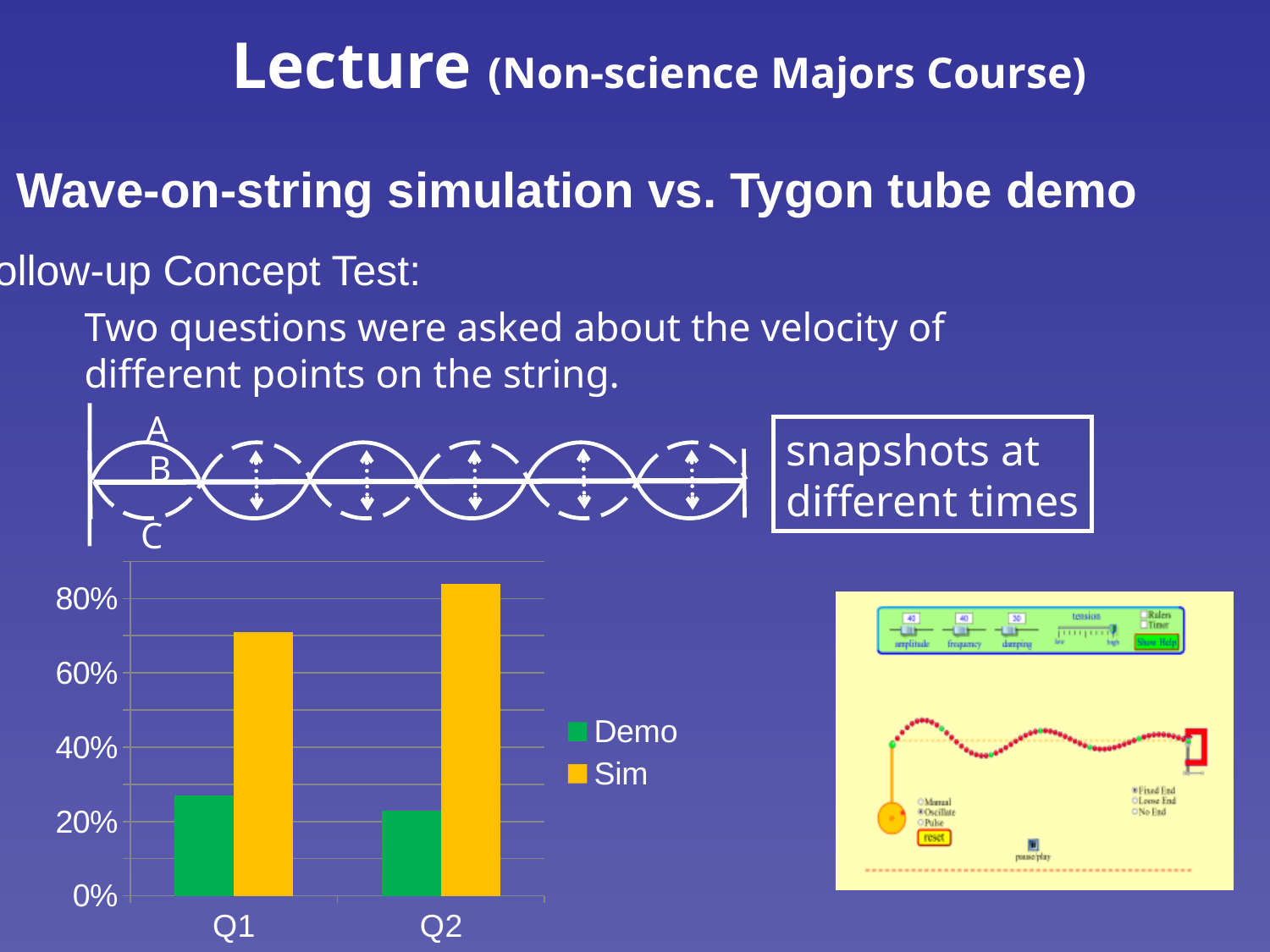
Is the Sim value for Q2 greater or less than 80%? greater How many categories are shown on the x axis of the chart? 2 How many series does the chart legend list? 2 For Q1, which series has the larger value, Demo or Sim? Sim Which bar in the chart is the tallest? Sim for Q2 Is the Demo value for Q2 greater or less than 20%? greater Is the Demo value for Q1 greater or less than 40%? less Does the Sim value rise or fall from Q1 to Q2? rise What are the two entries in the chart legend? Demo and Sim Which series is shown in yellow in the chart? Sim What kind of chart is shown on the slide? bar chart